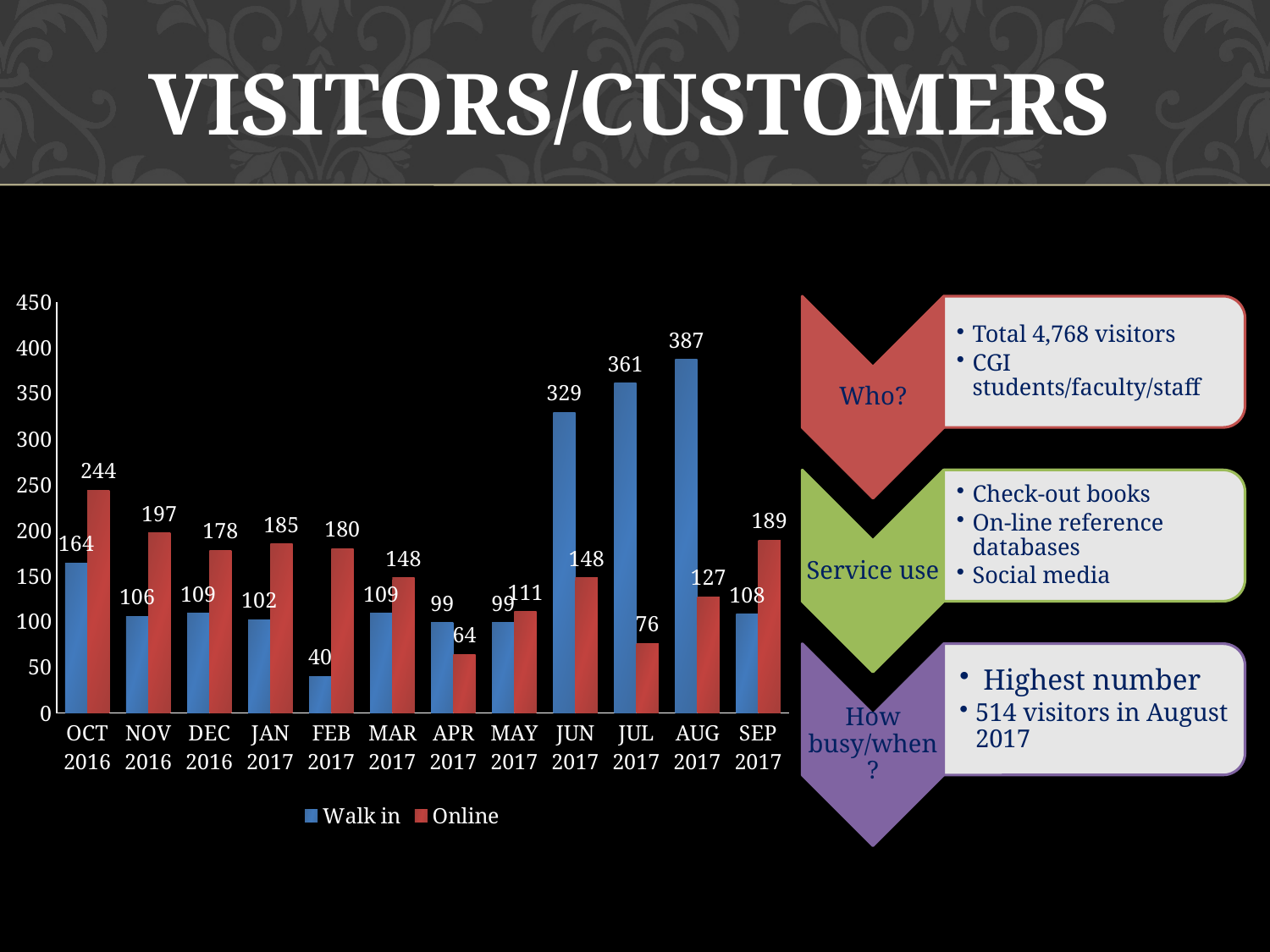
How many months are shown on the x axis? 12 What is the Walk in value for FEB 2017? 40 Which month has the highest Walk in value? AUG 2017 What kind of chart is shown on the slide? Bar chart What is the difference between the Walk in and Online values for JUL 2017? 285 Which colour represents the Online series in the chart? Red Which month has the lowest Online value? APR 2017 What is the Online value for OCT 2016? 244 Which is larger for JAN 2017, the Walk in value or the Online value? Online What is the total of the Walk in and Online values for SEP 2017? 297 How many series does the legend list? 2 What is the Walk in value for AUG 2017? 387